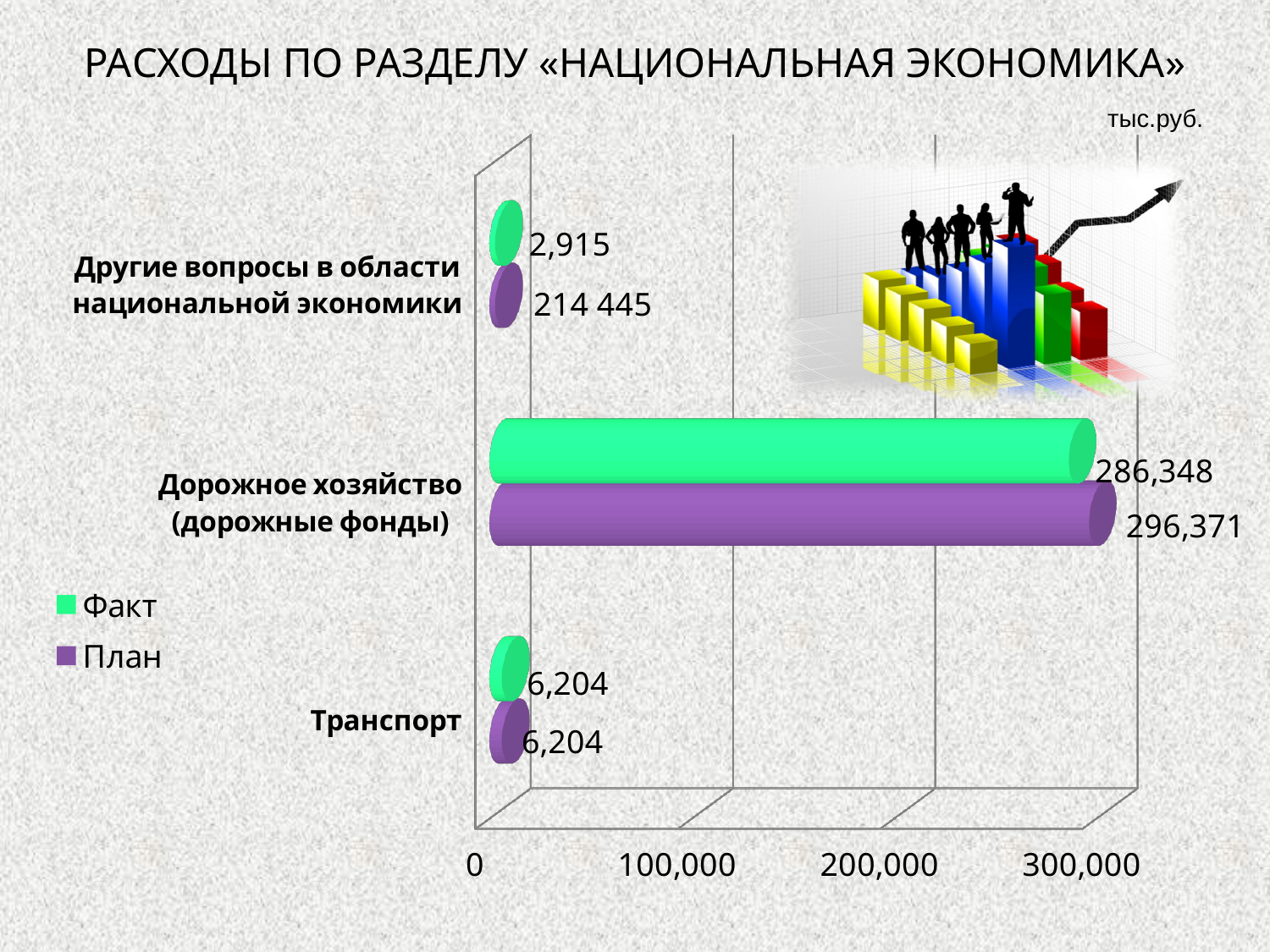
What is the План value for Дорожное хозяйство (дорожные фонды)? 296,371 What unit is indicated in the top right corner of the chart? тыс.руб. For Дорожное хозяйство (дорожные фонды), which is larger: the Факт value or the План value? План What is the Факт value for Транспорт? 6,204 How many series does the legend list? 2 Which category has the highest Факт value? Дорожное хозяйство (дорожные фонды) How many categories are plotted on the chart? 3 What is the Факт value for Другие вопросы в области национальной экономики? 2,915 Which category has the lowest Факт value? Другие вопросы в области национальной экономики What kind of chart is shown on the slide? bar chart What is the Факт value for Дорожное хозяйство (дорожные фонды)? 286,348 What is the difference between the План and Факт values for Дорожное хозяйство (дорожные фонды)? 10,023